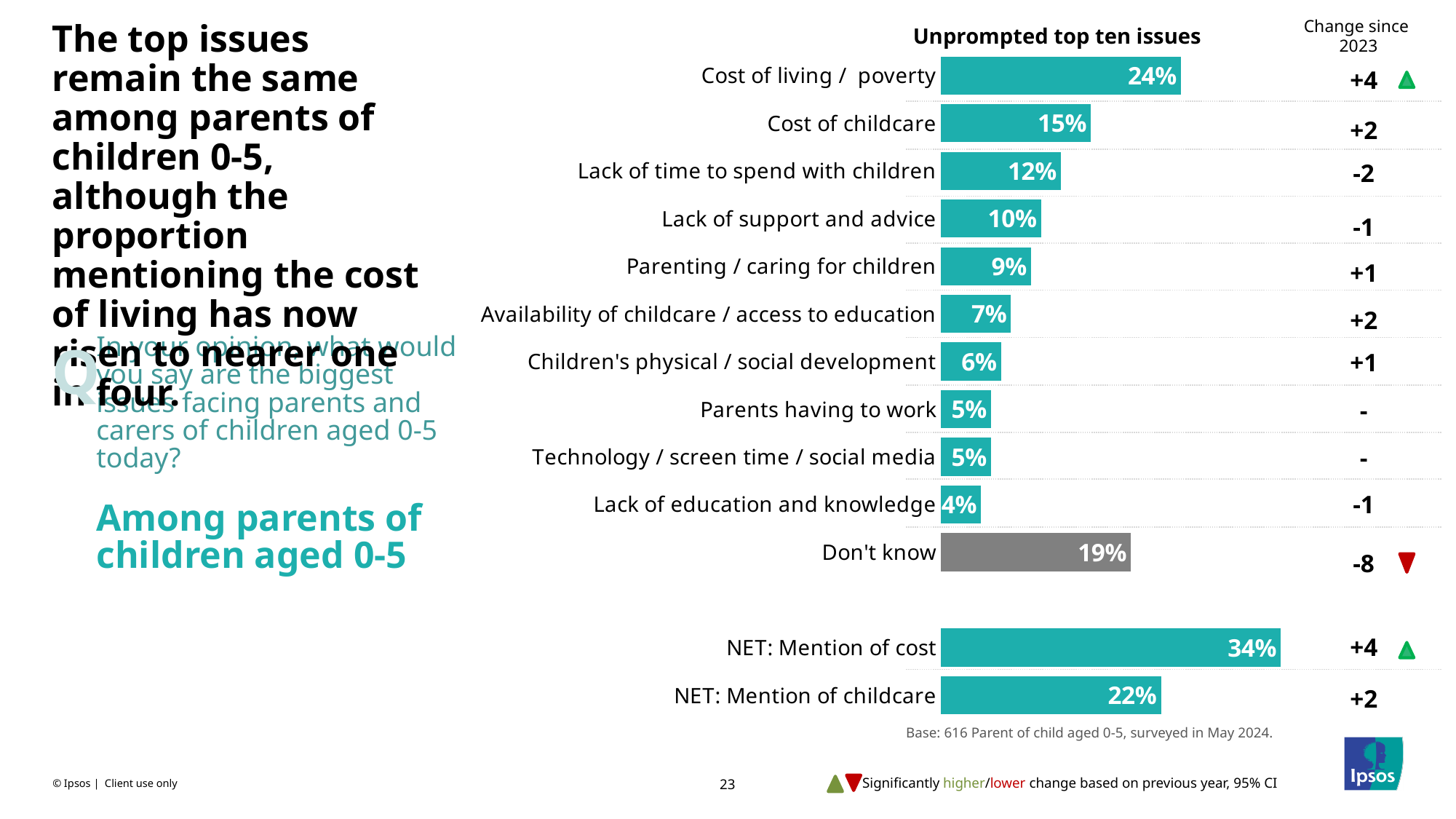
Which is larger: the value for 'Lack of time to spend with children' or 'Lack of support and advice'? Lack of time to spend with children What is the change since 2023 shown for 'Cost of living / poverty'? +4 What is the difference in percentage points between 'Cost of living / poverty' and 'Cost of childcare'? 9 percentage points How many bars are plotted in the chart in total, including 'Don't know' and the two NET rows? 13 What type of chart is shown on the slide? Bar chart What is the title of the chart? Unprompted top ten issues What is the change since 2023 shown for 'Don't know'? -8 What is the value for 'NET: Mention of cost'? 34% What percentage of parents mentioned cost of living / poverty as a top issue? 24% Which of the top ten issues has the highest percentage? Cost of living / poverty Which of the top ten issues has the lowest percentage? Lack of education and knowledge What is the value shown for 'Don't know'? 19%